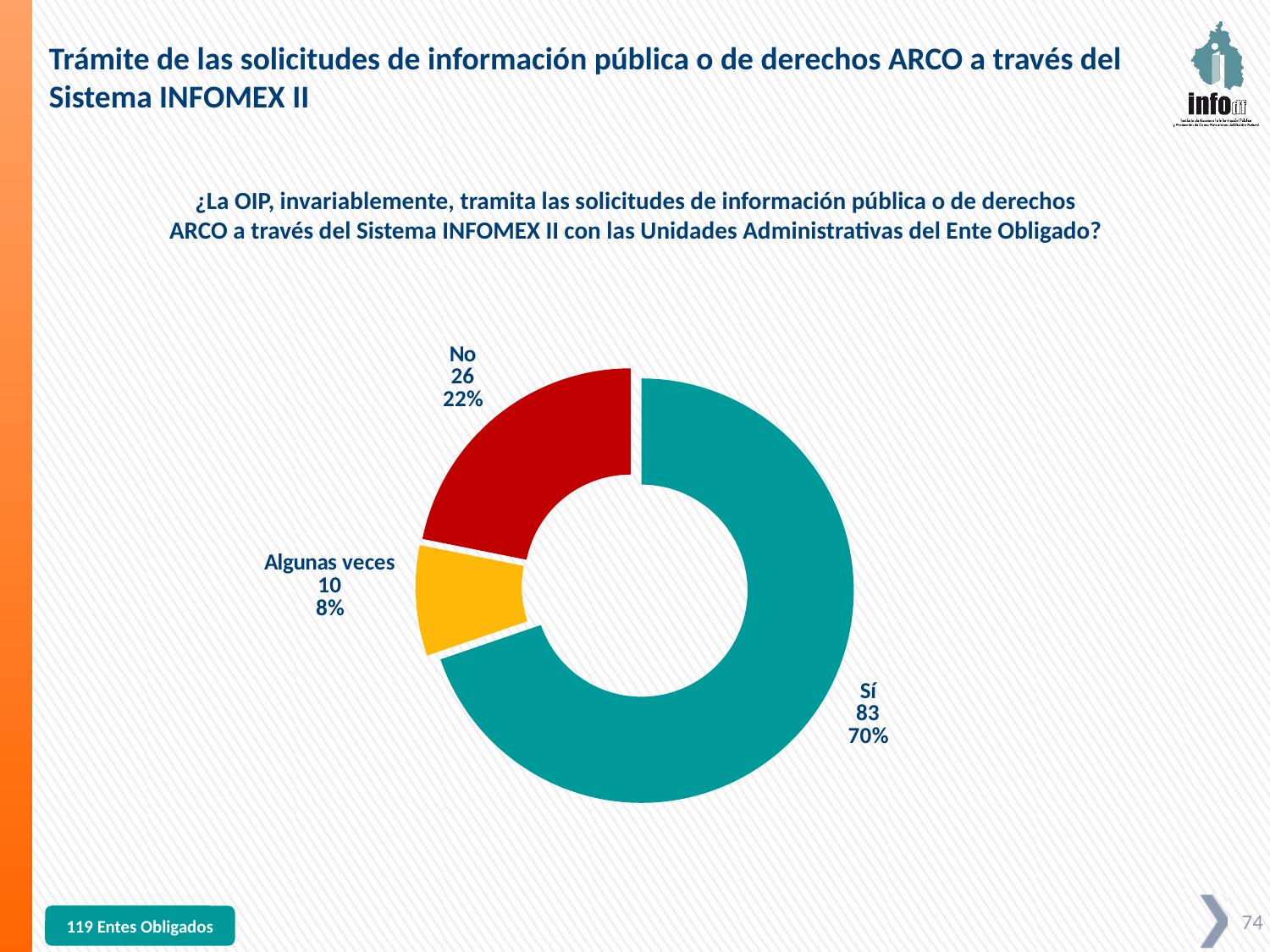
What is the total count across all three categories? 119 What colour is the 'No' slice? Red Which category has the largest share? Sí Which is larger, the count for 'No' or for 'Algunas veces'? No What is the count for the 'Sí' category? 83 What kind of chart is shown on the slide? Doughnut (pie) chart Which category has the smallest share? Algunas veces What is the count for 'Algunas veces'? 10 What percentage share does the 'No' category have? 22% What is the difference in count between 'Sí' and 'No'? 57 What percentage share does 'Sí' have? 70% How many categories does the chart show? 3